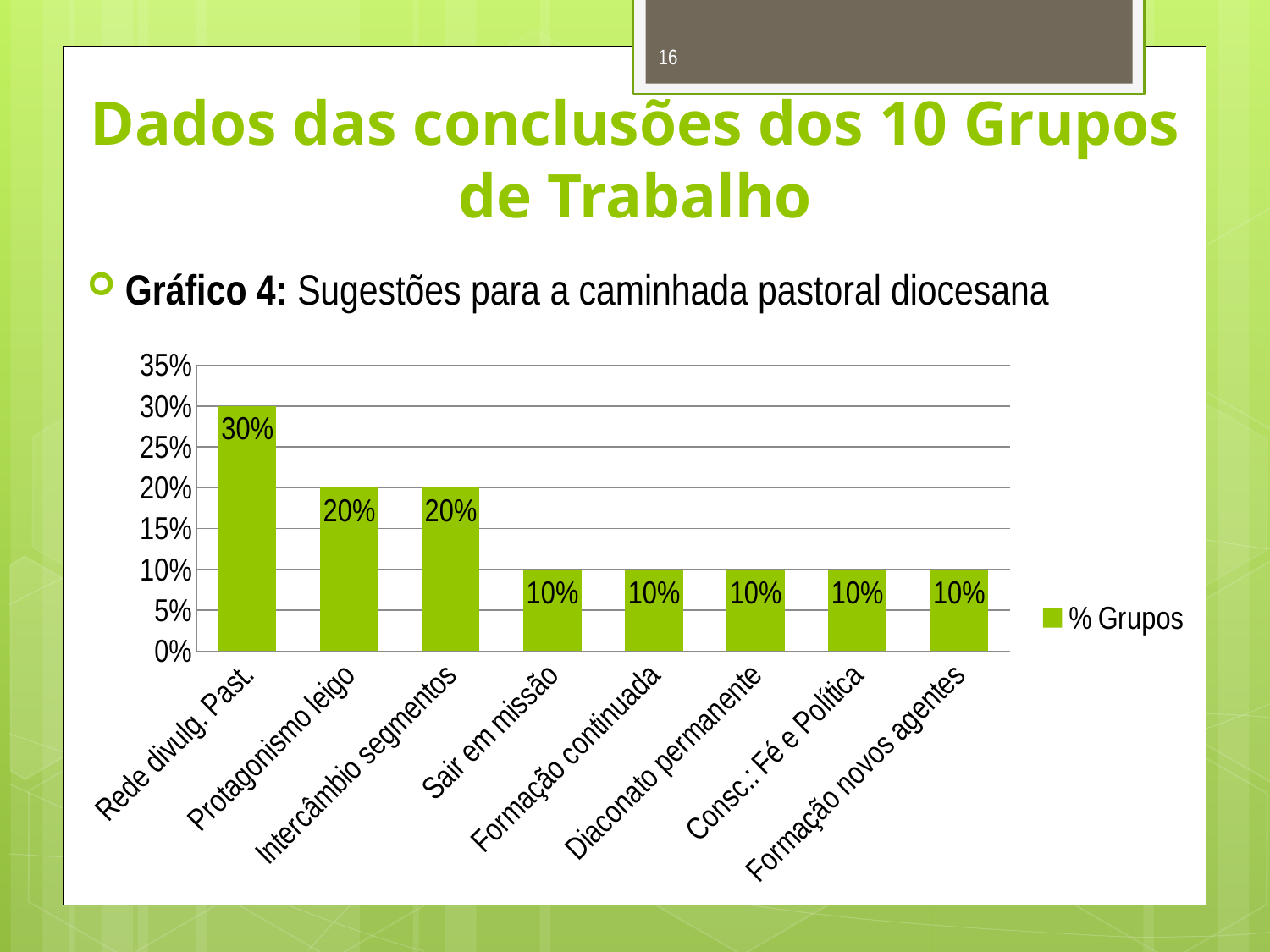
How many series does the legend list? 1 What is the name of the series in the legend? % Grupos Which is larger, the value for Intercâmbio segmentos or the value for Formação continuada? Intercâmbio segmentos What is the value for Rede divulg. Past.? 30% How many categories are shown on the x axis? 8 What is the value for Protagonismo leigo? 20% What is the difference between the values for Rede divulg. Past. and Intercâmbio segmentos? 10% What is the difference between the values for Protagonismo leigo and Diaconato permanente? 10% Which category has the highest value? Rede divulg. Past. What is the value for Sair em missão? 10% What kind of chart is shown? bar chart Do the values rise or fall from left to right along the x axis? fall